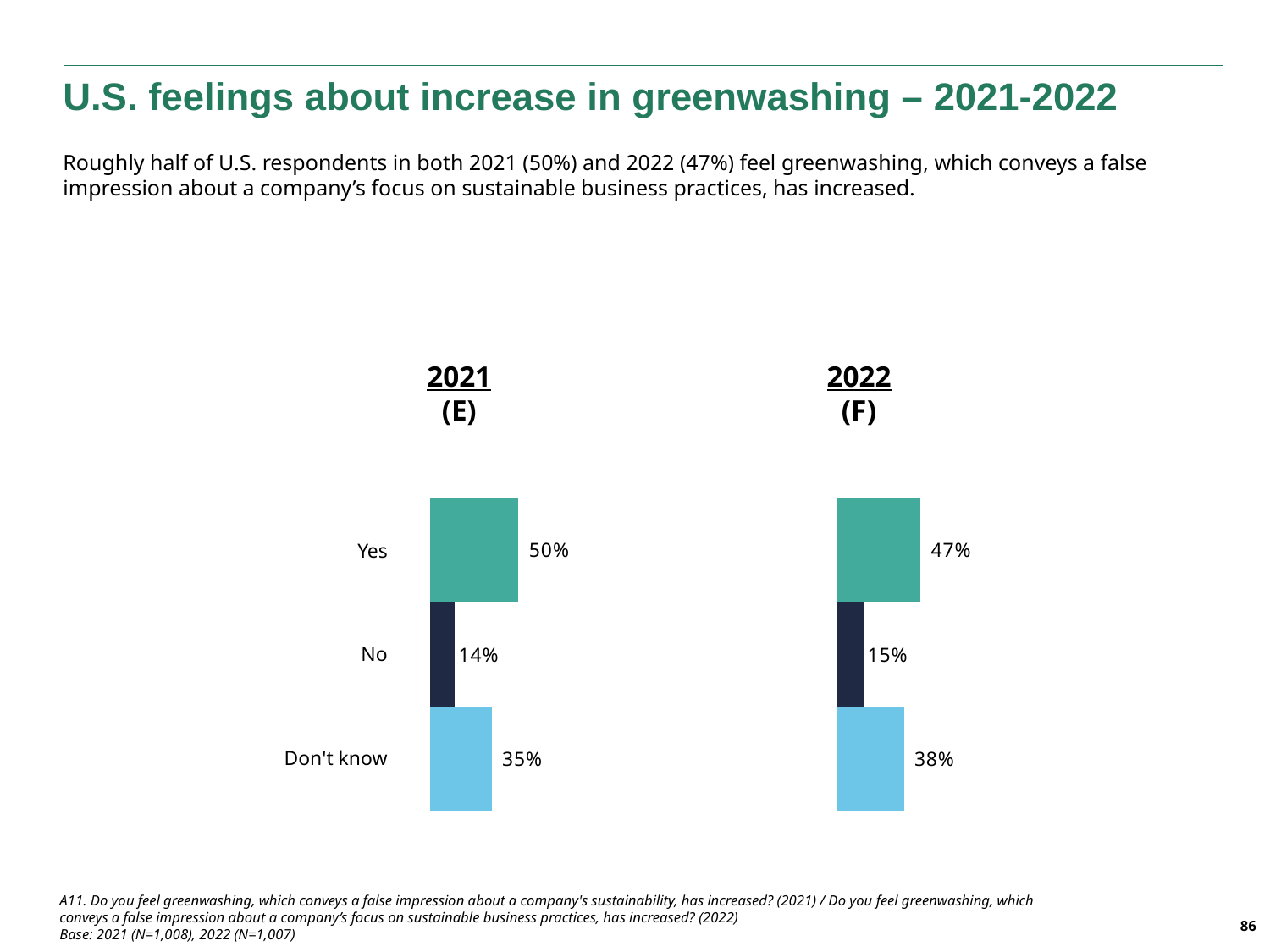
In the 2021 (E) chart, what is the difference between the Yes and Don't know values? 15% In the 2021 (E) chart, what is the value for Yes? 50% How many categories are shown in the 2021 (E) chart? 3 In the 2021 (E) chart, what is the value for No? 14% In the 2022 (F) chart, what is the value for Don't know? 38% In the 2022 (F) chart, which category has the highest value? Yes In the 2022 (F) chart, what is the value for Yes? 47% What kind of chart is the 2022 (F) chart? Bar chart Which is larger: the Yes value in the 2021 (E) chart or the Yes value in the 2022 (F) chart? 2021 (E) In the 2021 (E) chart, which category has the lowest value? No What colour is the Don't know bar in the 2021 (E) chart? Light blue In the 2022 (F) chart, what is the difference between the Don't know and No values? 23%